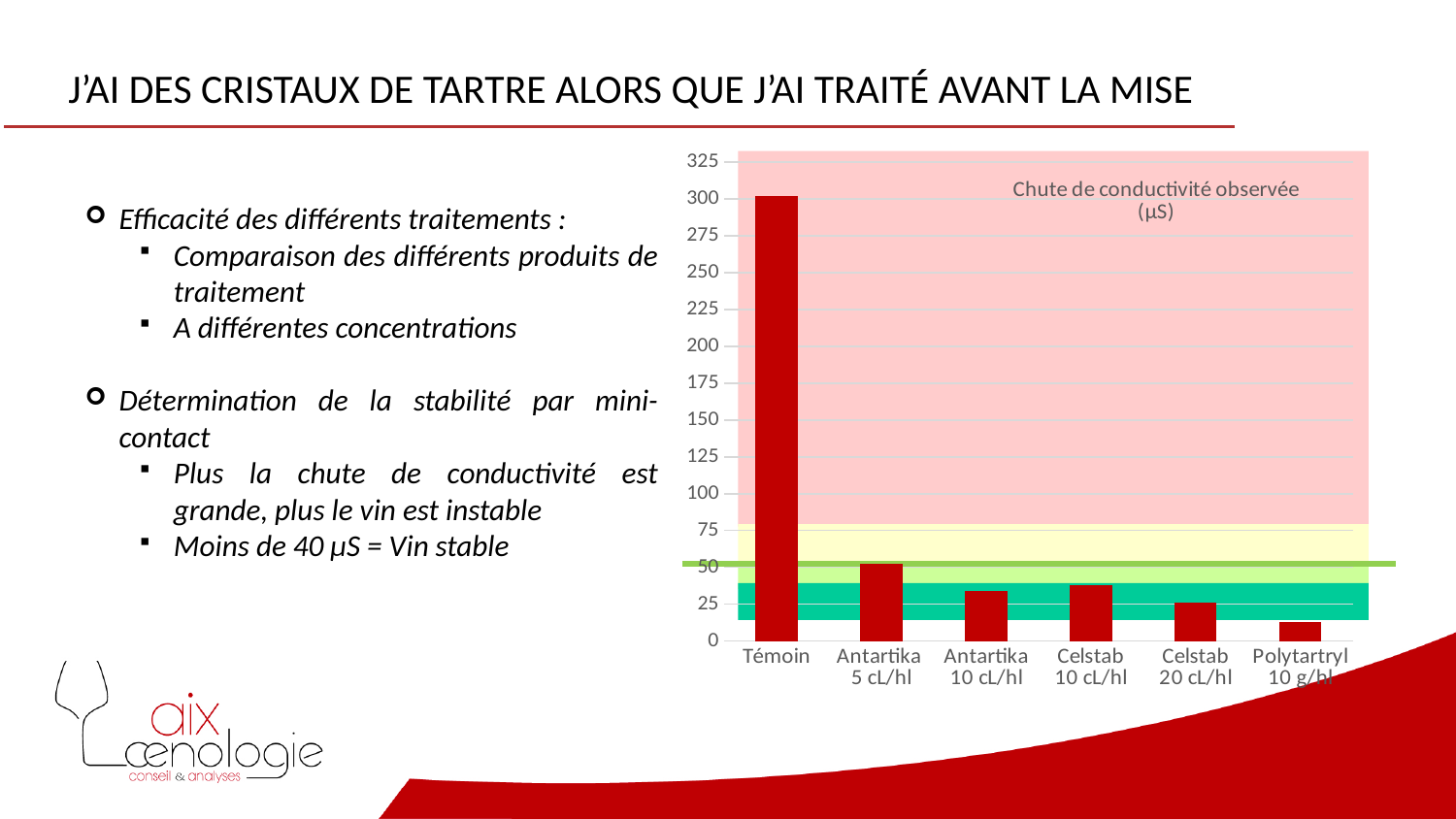
Which is larger, the value for Antartika 5 cL/hl or Antartika 10 cL/hl? Antartika 5 cL/hl Is the value for Antartika 5 cL/hl greater or less than 75? less How many categories are shown on the x axis of the chart? 6 Is the value for Témoin greater or less than 275? greater Is the value for Polytartryl 10 g/hl greater or less than 25? less Which category has the highest value in the chart? Témoin What is the title of the chart? Chute de conductivité observée (µS) What type of chart is shown on the slide? bar chart Which is larger, the value for Celstab 10 cL/hl or Celstab 20 cL/hl? Celstab 10 cL/hl Which category has the lowest value in the chart? Polytartryl 10 g/hl